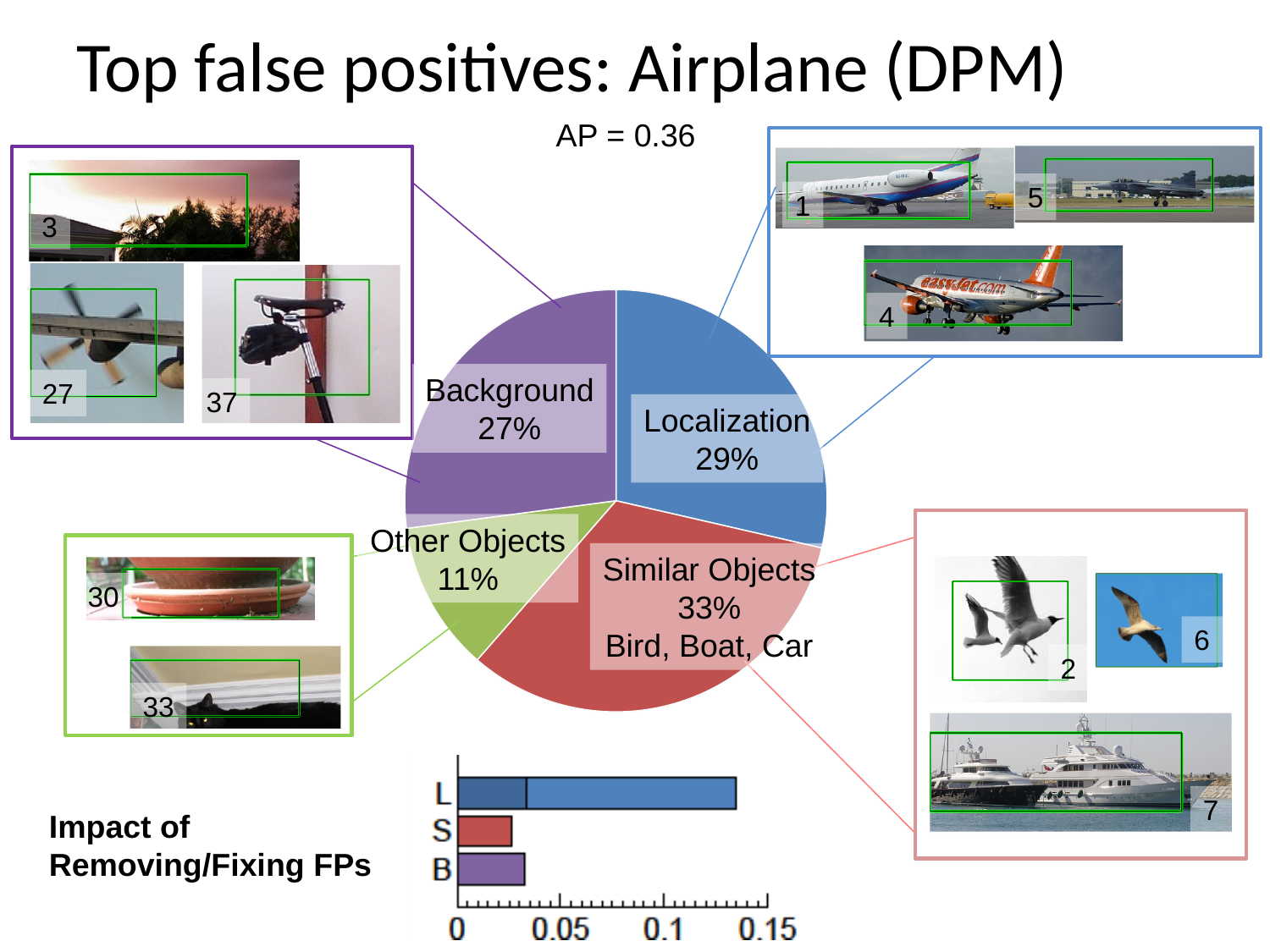
In the pie chart, which similar object classes are listed under the Similar Objects slice? Bird, Boat, Car In the pie chart, which category has the smallest share? Other Objects In the pie chart, which is larger, Localization or Background? Localization In the pie chart, what percentage is shown for Localization? 29% In the bar chart at the bottom (Impact of Removing/Fixing FPs), is the value for S greater or less than 0.05? less In the bar chart at the bottom (Impact of Removing/Fixing FPs), which bar is the longest? L How many slices does the pie chart have? 4 In the pie chart, what share of false positives is attributed to Similar Objects? 33% In the pie chart, what percentage is shown for Other Objects? 11% In the bar chart at the bottom (Impact of Removing/Fixing FPs), is the value for L greater or less than 0.1? greater In the pie chart, which category has the largest share? Similar Objects In the pie chart, what is the difference in percentage points between Similar Objects and Background? 6